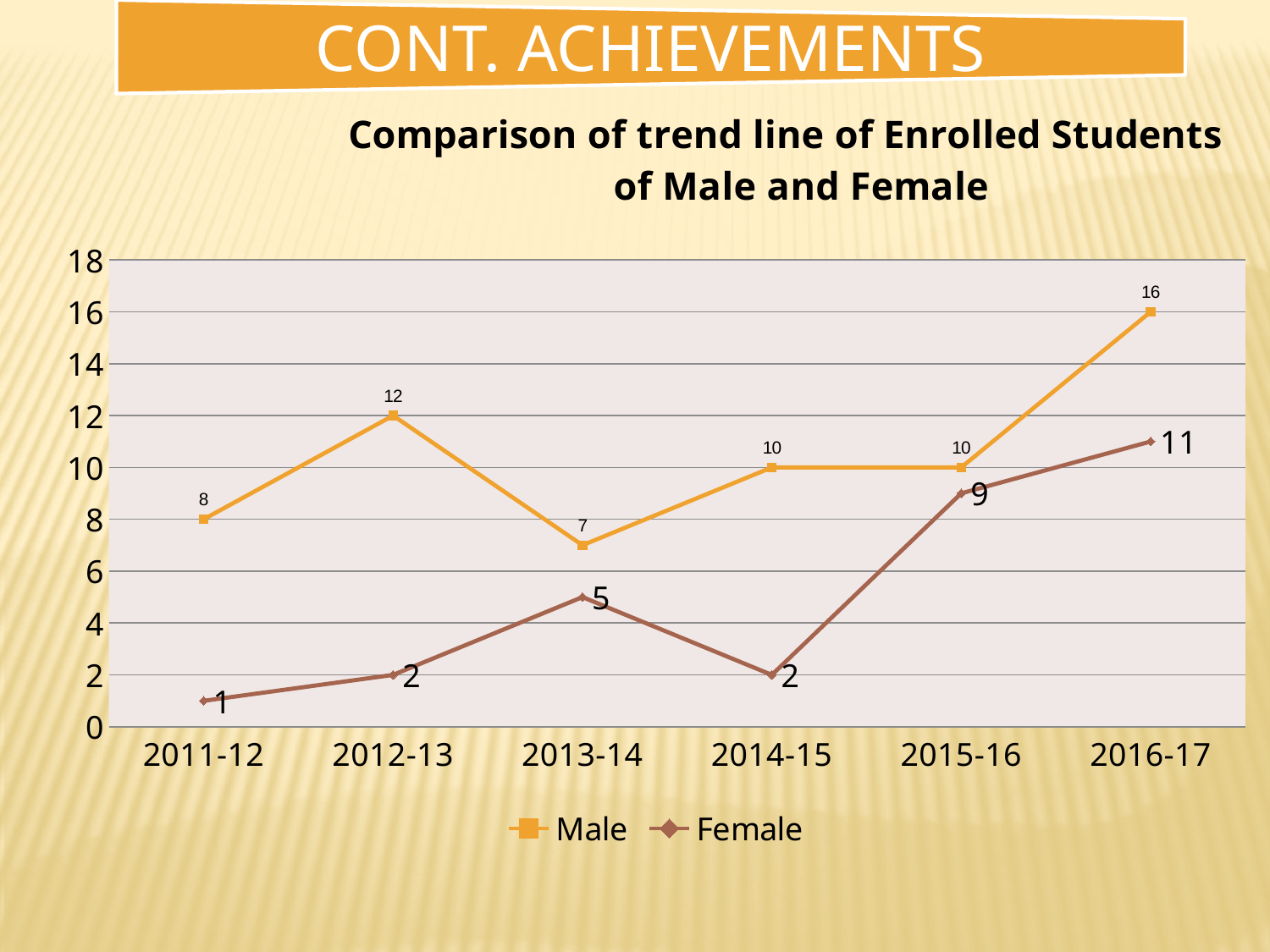
What is the Male value for 2013-14? 7 Does the Female series rise or fall from 2014-15 to 2016-17? Rise What is the Female value for 2015-16? 9 In which year is the Female series lowest? 2011-12 What is the difference between the Male and Female values in 2016-17? 5 How many years are shown on the x axis? 6 In which year is the Male series highest? 2016-17 What kind of chart is shown on the slide? Line chart Which is larger in 2014-15, the Male value or the Female value? Male How many series does the legend list? 2 What is the Male value for 2012-13? 12 What is the title of the chart? Comparison of trend line of Enrolled Students of Male and Female